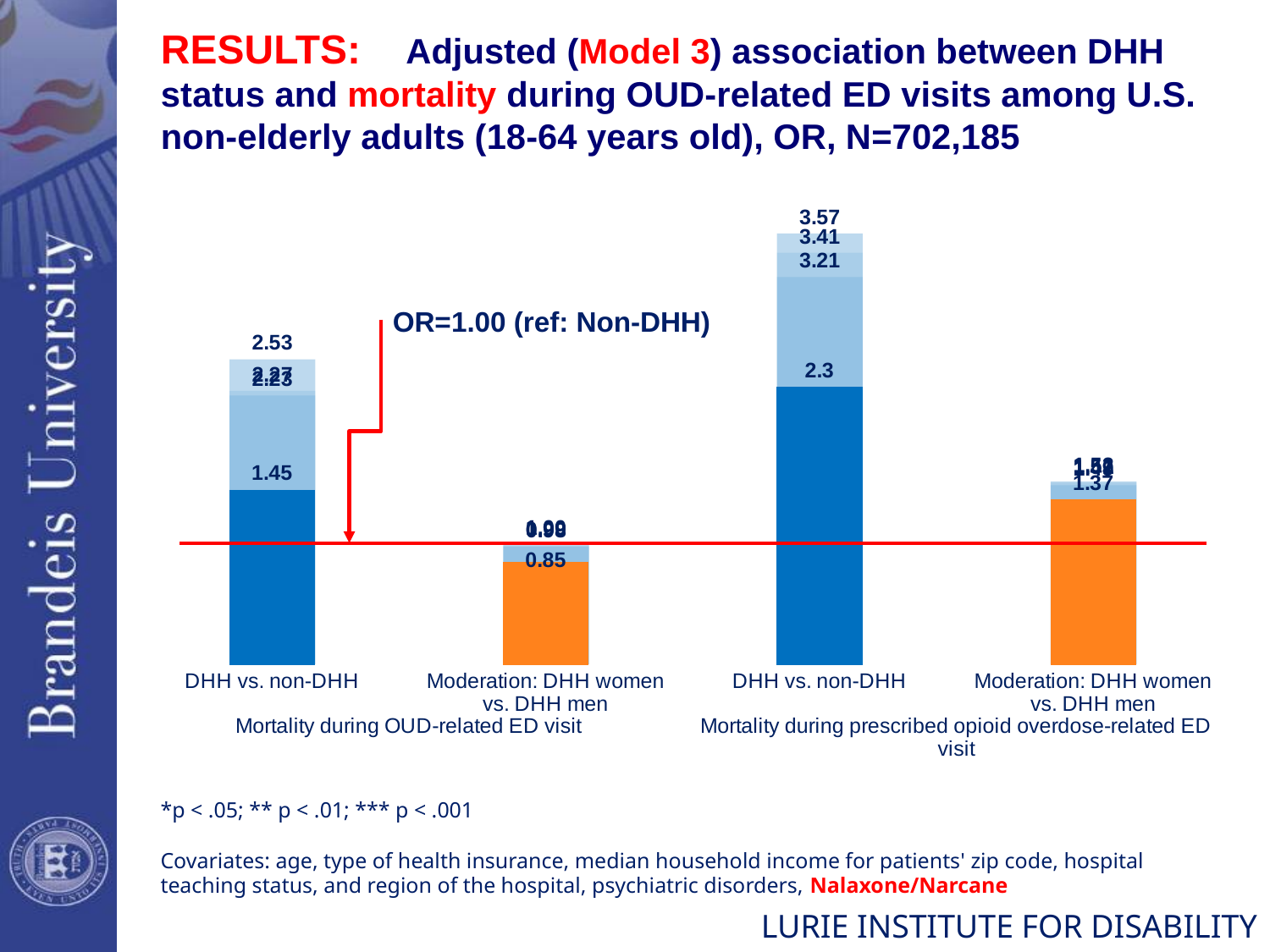
What is the topmost value labelled on the 'DHH vs. non-DHH' bar under 'Mortality during OUD-related ED visit'? 2.53 What is the topmost value labelled on the 'DHH vs. non-DHH' bar under 'Mortality during prescribed opioid overdose-related ED visit'? 3.57 What is the difference between the topmost labelled values of the two 'DHH vs. non-DHH' bars (3.57 and 2.53)? 1.04 What is the lowest value labelled on the dark blue segment of the 'DHH vs. non-DHH' bar under 'Mortality during OUD-related ED visit'? 1.45 What is the value labelled on the dark blue segment of the 'DHH vs. non-DHH' bar under 'Mortality during prescribed opioid overdose-related ED visit'? 2.3 Which bar reaches the highest labelled value on the chart? DHH vs. non-DHH (Mortality during prescribed opioid overdose-related ED visit) Which bar has the lowest labelled value on the chart? Moderation: DHH women vs. DHH men (Mortality during OUD-related ED visit) What value is labelled on the orange segment of the 'Moderation: DHH women vs. DHH men' bar under 'Mortality during OUD-related ED visit'? 0.85 What value is labelled on the orange segment of the 'Moderation: DHH women vs. DHH men' bar under 'Mortality during prescribed opioid overdose-related ED visit'? 1.37 How many bars (categories) are plotted on the chart? 4 What reference value does the red horizontal line on the chart represent? OR=1.00 (ref: Non-DHH) What kind of chart is shown on the slide? bar chart